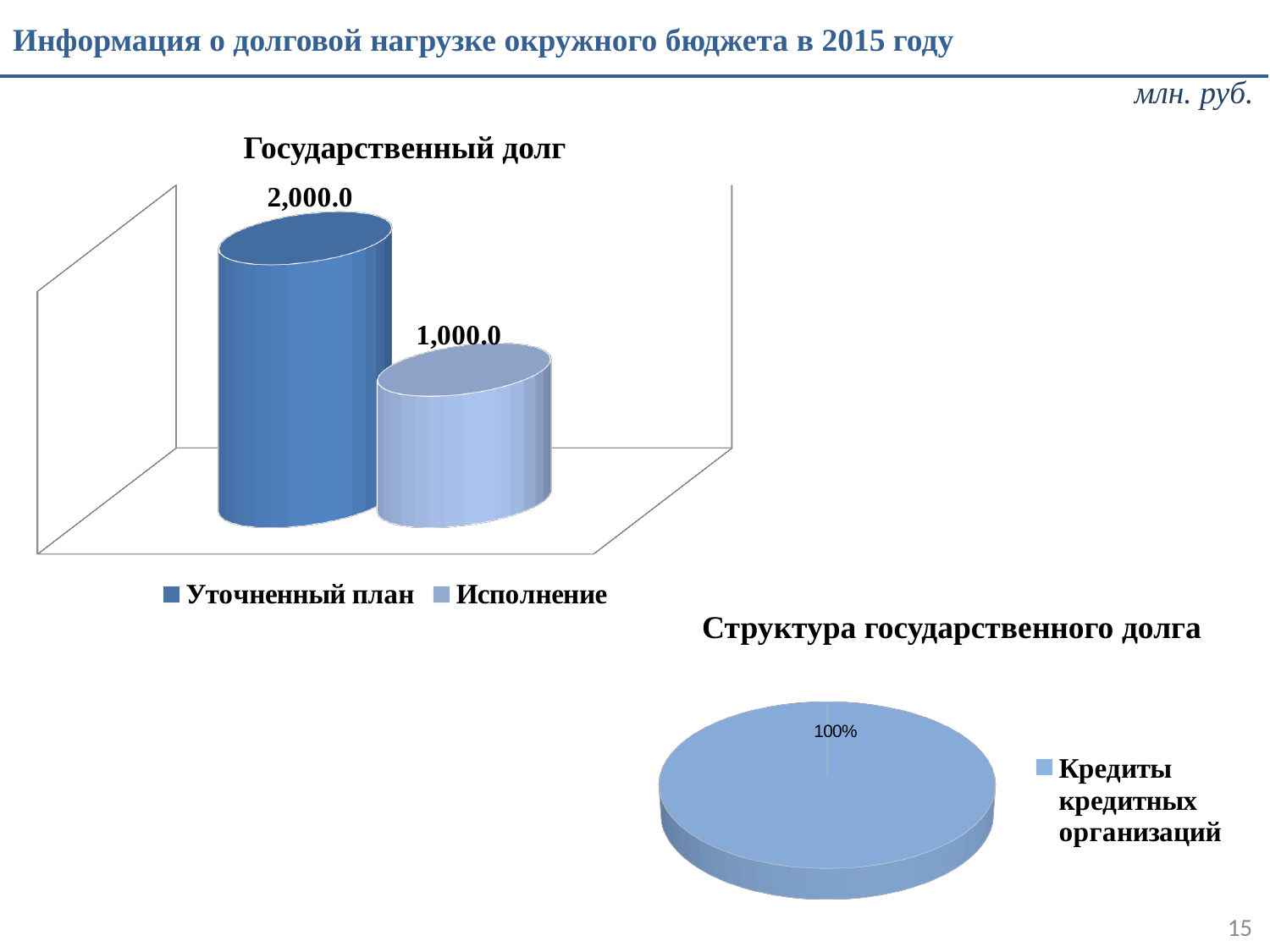
In the 'Государственный долг' chart, which series has the higher value? Уточненный план In the 'Государственный долг' chart, what is the difference between 'Уточненный план' and 'Исполнение'? 1,000.0 What unit of measurement is indicated on the slide for the charts? млн. руб. What kind of chart is the 'Государственный долг' chart? bar chart In the 'Государственный долг' chart, is the value for 'Уточненный план' larger or smaller than the value for 'Исполнение'? larger How many slices does the 'Структура государственного долга' pie chart have? 1 In the 'Структура государственного долга' chart, what share does 'Кредиты кредитных организаций' have? 100% In the 'Государственный долг' chart, what is the value for 'Исполнение'? 1,000.0 How many series does the legend of the 'Государственный долг' chart list? 2 What kind of chart is the 'Структура государственного долга' chart? pie chart In the 'Государственный долг' chart, which series has the lower value? Исполнение In the 'Государственный долг' chart, what is the value for 'Уточненный план'? 2,000.0